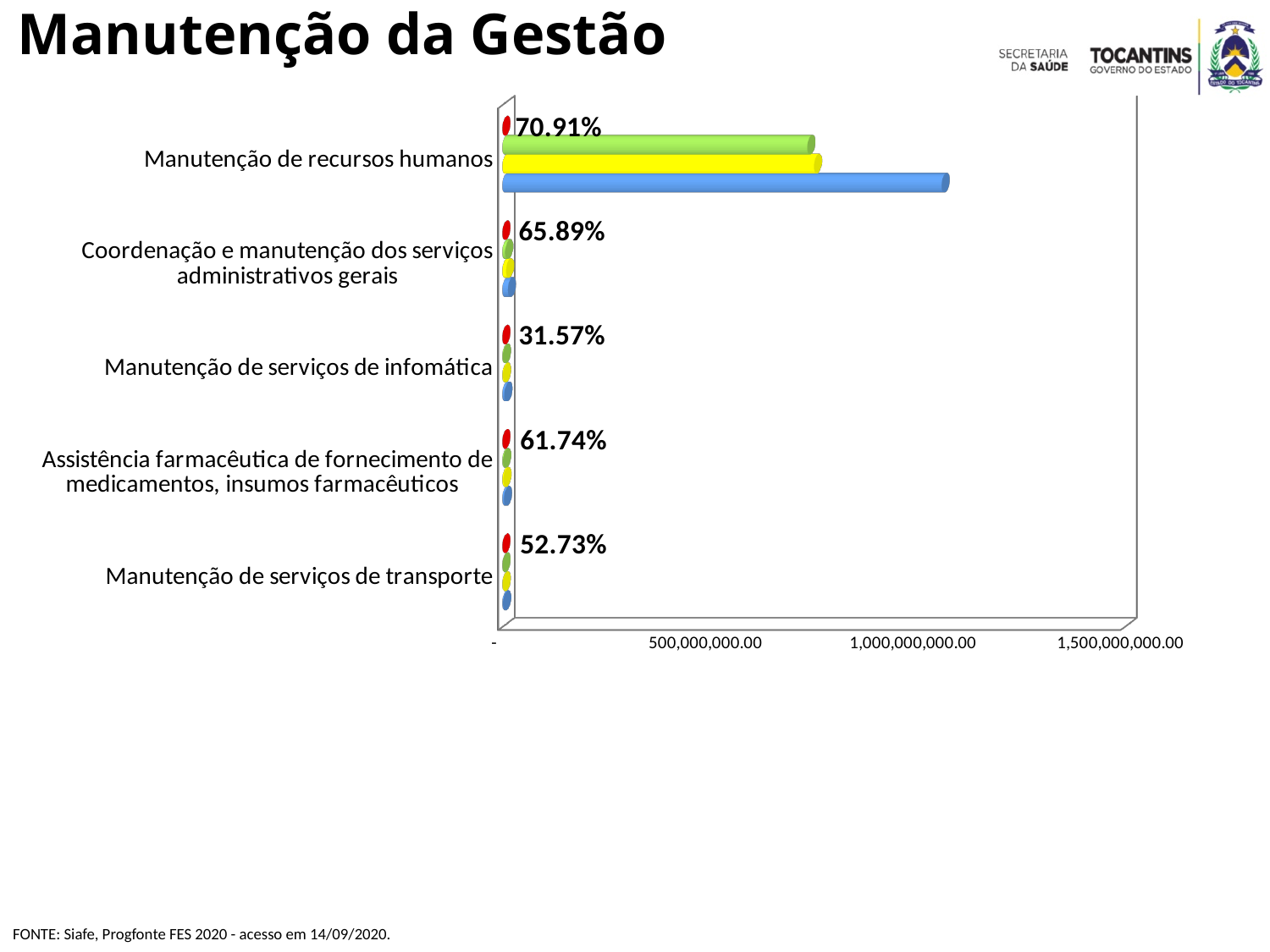
How many categories are shown on the chart? 5 Which has the larger percentage label: Coordenação e manutenção dos serviços administrativos gerais or Assistência farmacêutica de fornecimento de medicamentos, insumos farmacêuticos? Coordenação e manutenção dos serviços administrativos gerais Is the value of the blue bar for Manutenção de recursos humanos greater or less than 1,000,000,000.00? greater Which category has the lowest percentage label? Manutenção de serviços de infomática What percentage is shown for Manutenção de serviços de infomática? 31.57% What kind of chart is shown on the slide? Bar chart What percentage is shown for Manutenção de serviços de transporte? 52.73% Which category has the highest percentage label? Manutenção de recursos humanos What percentage is shown for Assistência farmacêutica de fornecimento de medicamentos, insumos farmacêuticos? 61.74% What is the difference in percentage points between the labels for Manutenção de recursos humanos and Manutenção de serviços de infomática? 39.34 percentage points What percentage is shown for Manutenção de recursos humanos? 70.91% What percentage is shown for Coordenação e manutenção dos serviços administrativos gerais? 65.89%